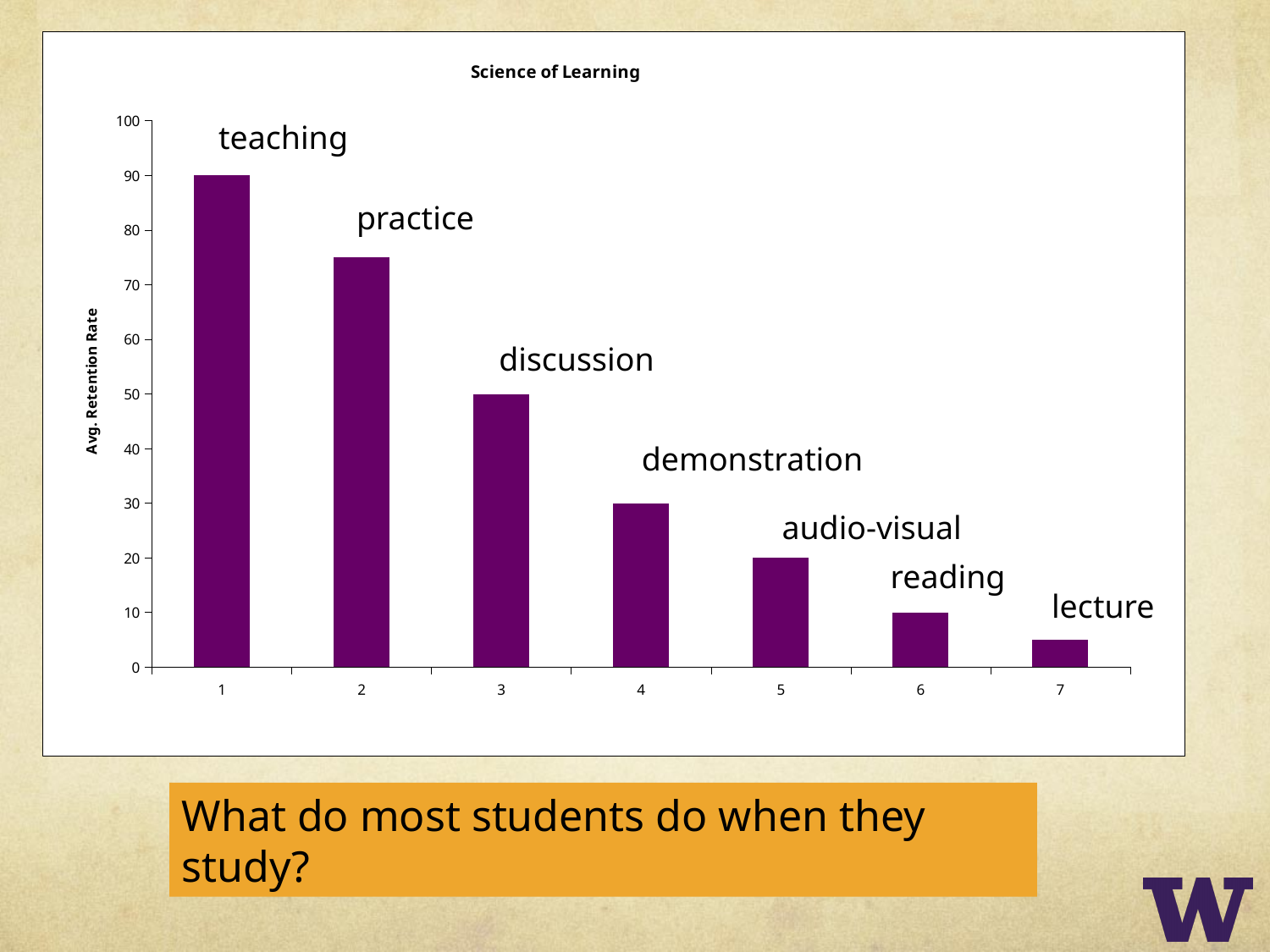
What is the average retention rate for demonstration? 30 Is the value for practice greater or less than 70? greater What is the label of the vertical axis? Avg. Retention Rate Which learning method has the lowest average retention rate? lecture Do the values rise or fall from left to right along the x axis? fall Which learning method has the highest average retention rate? teaching What is the average retention rate for teaching? 90 What is the average retention rate for reading? 10 What type of chart is shown on the slide? bar chart How many bars are plotted in the chart? 7 What is the average retention rate for discussion? 50 What is the title of the chart? Science of Learning